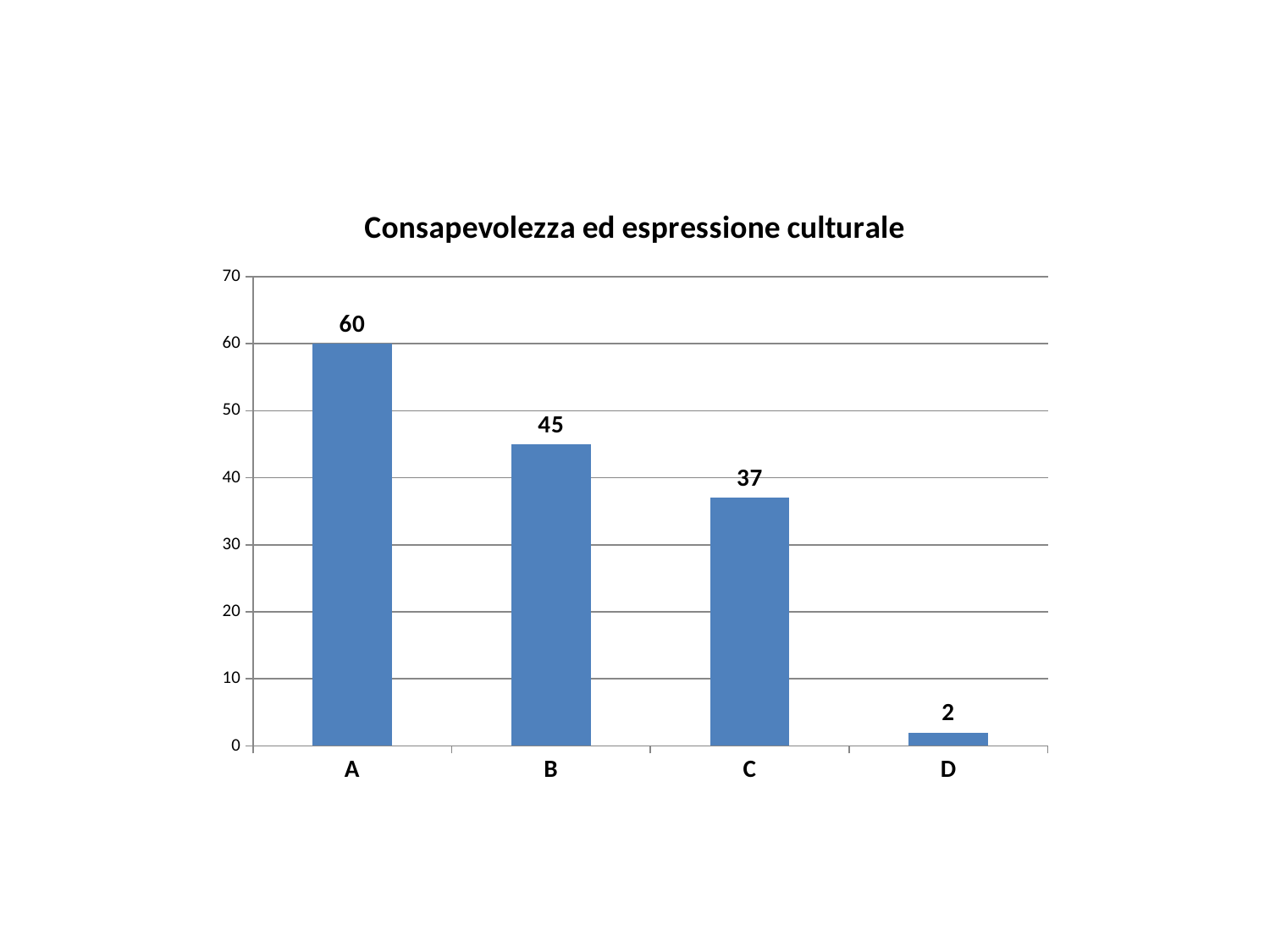
What is the value for category D? 2 What is the value for category A? 60 Which is larger, the value for B or the value for C? B Which category has the highest value? A Is the value for C greater or less than 40? less What is the difference between the values for A and B? 15 What is the difference between the values for B and C? 8 What is the value for category C? 37 What kind of chart is shown? bar chart Do the values rise or fall from A to D along the x axis? fall Which category has the lowest value? D How many categories are shown on the x axis? 4